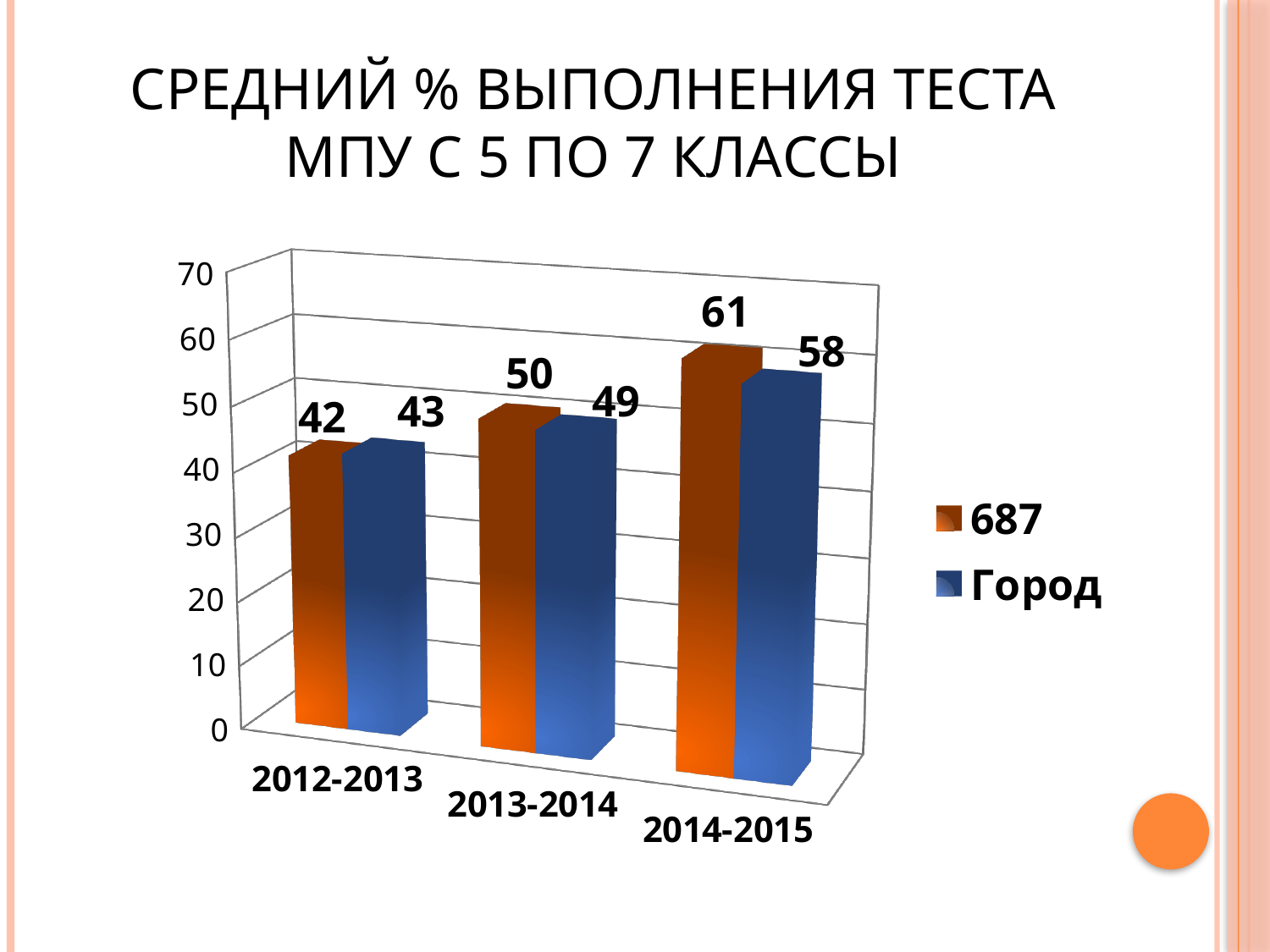
What is the difference between 687 and Город in 2014-2015? 3 What is the value for Город in 2013-2014? 49 Which is larger in 2013-2014, 687 or Город? 687 What kind of chart is shown on the slide? bar chart What is the value for 687 in 2012-2013? 42 In which year is the value for 687 highest? 2014-2015 In which year is the value for Город lowest? 2012-2013 How many series does the legend list? 2 Do the values for 687 rise or fall from 2012-2013 to 2014-2015? rise What is the value for 687 in 2014-2015? 61 What is the value for Город in 2012-2013? 43 How many year categories are shown on the x axis? 3